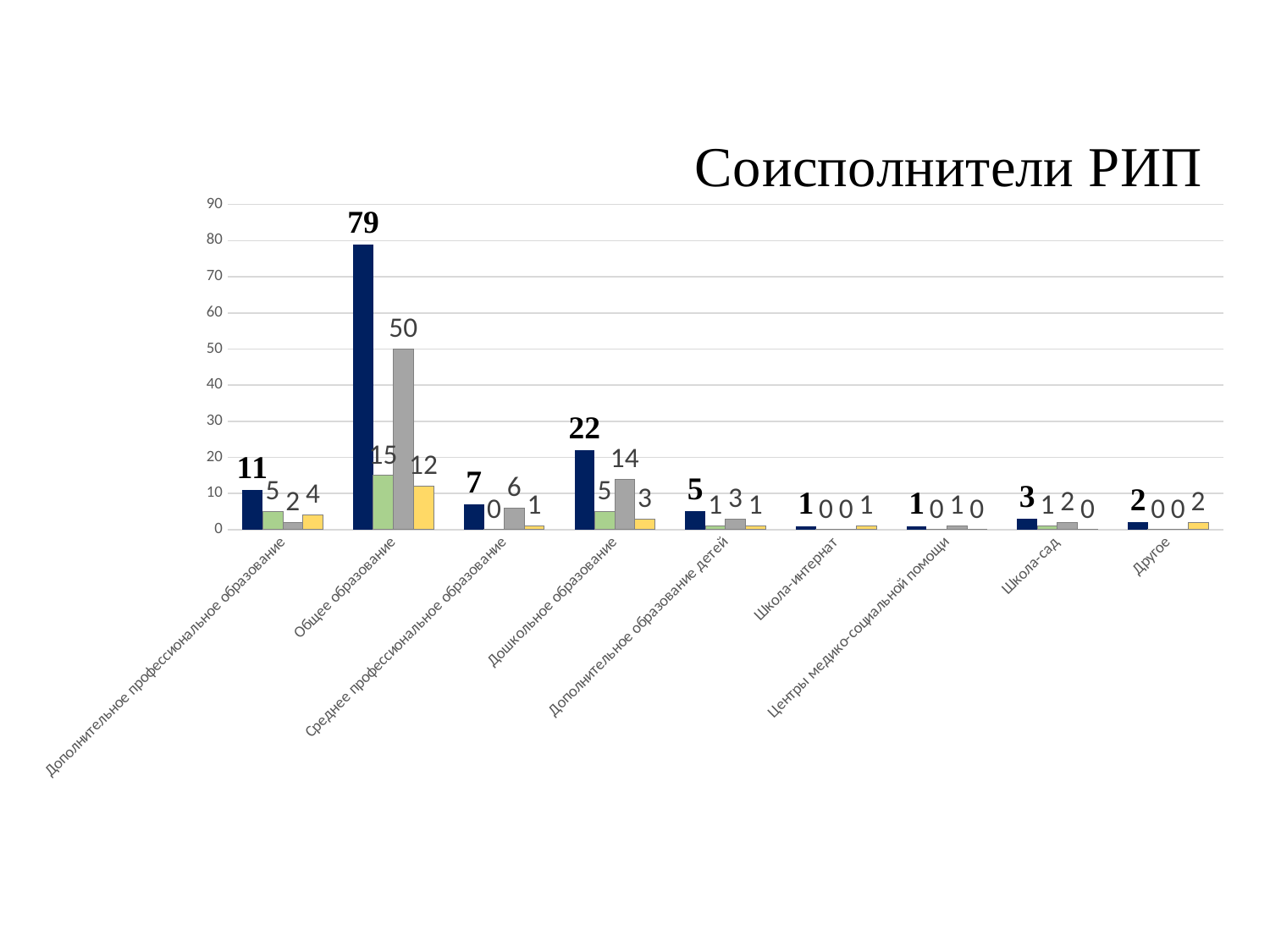
What is the difference between the dark blue bar and the grey bar for Общее образование? 29 What is the value of the dark blue bar for Общее образование? 79 What is the value of the yellow bar for Дополнительное профессиональное образование? 4 How many categories are shown on the x axis? 9 What is the title of the chart? Соисполнители РИП What is the value of the grey bar for Среднее профессиональное образование? 6 Which category has the highest dark blue bar? Общее образование What is the value of the dark blue bar for Школа-сад? 3 What type of chart is shown on the slide? bar chart Which is larger for Дошкольное образование: the green bar or the grey bar? the grey bar What is the value of the dark blue bar for Дошкольное образование? 22 What is the value of the grey bar for Общее образование? 50